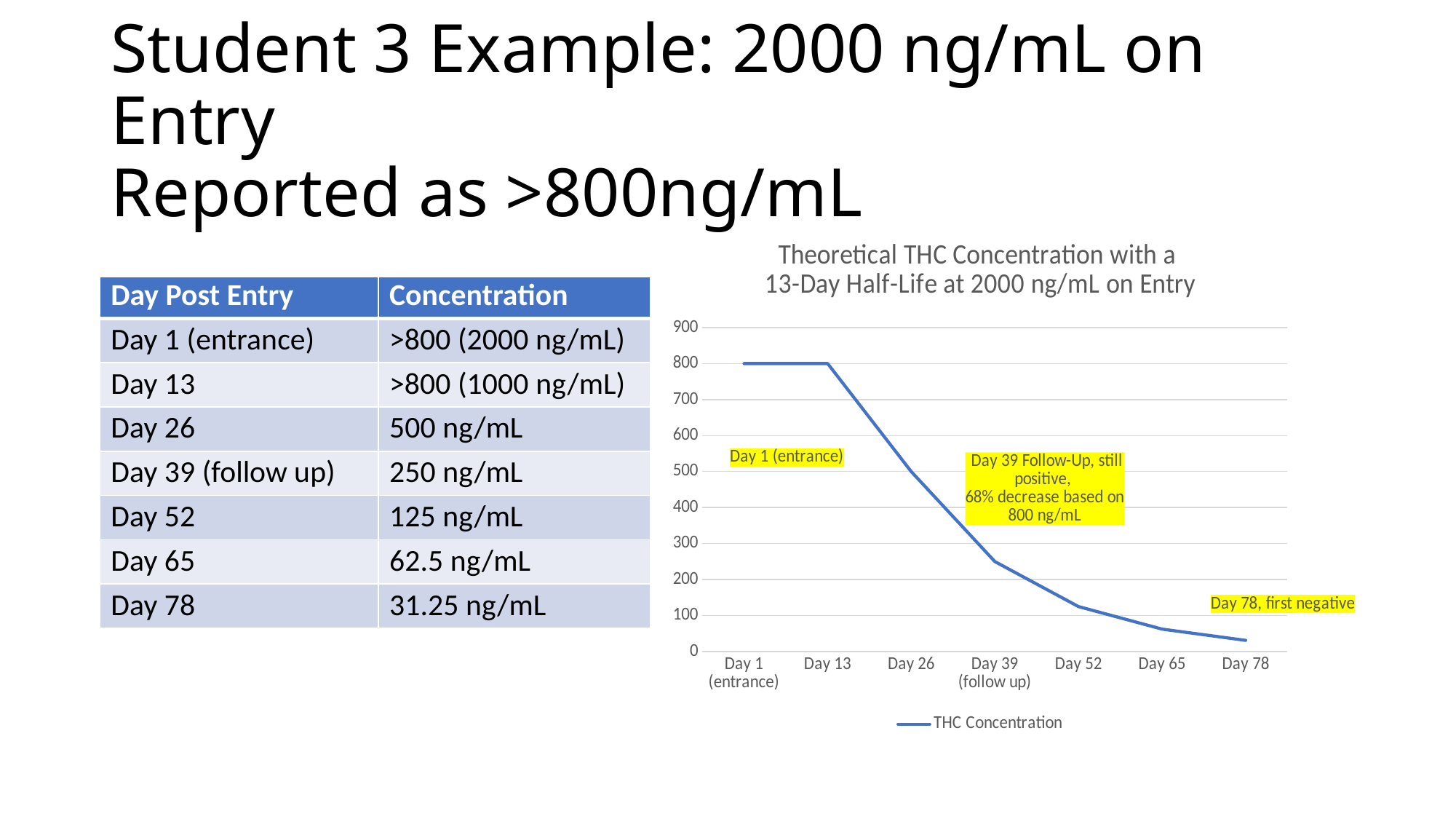
What is the name of the series shown in the chart legend? THC Concentration What is the plotted THC concentration at Day 26? 500 What is the plotted THC concentration at Day 1 (entrance)? 800 Is the plotted value for Day 39 (follow up) greater or less than 300? less Is the plotted value for Day 52 greater or less than 100? greater What kind of chart is shown on the slide? line chart How many points are plotted along the x axis of the chart? 7 Is the plotted value for Day 65 greater or less than 100? less How many series does the chart legend list? 1 Which has the larger plotted value, Day 26 or Day 52? Day 26 Do the plotted values rise or fall from Day 13 to Day 78? fall Which day has the lowest plotted THC concentration? Day 78